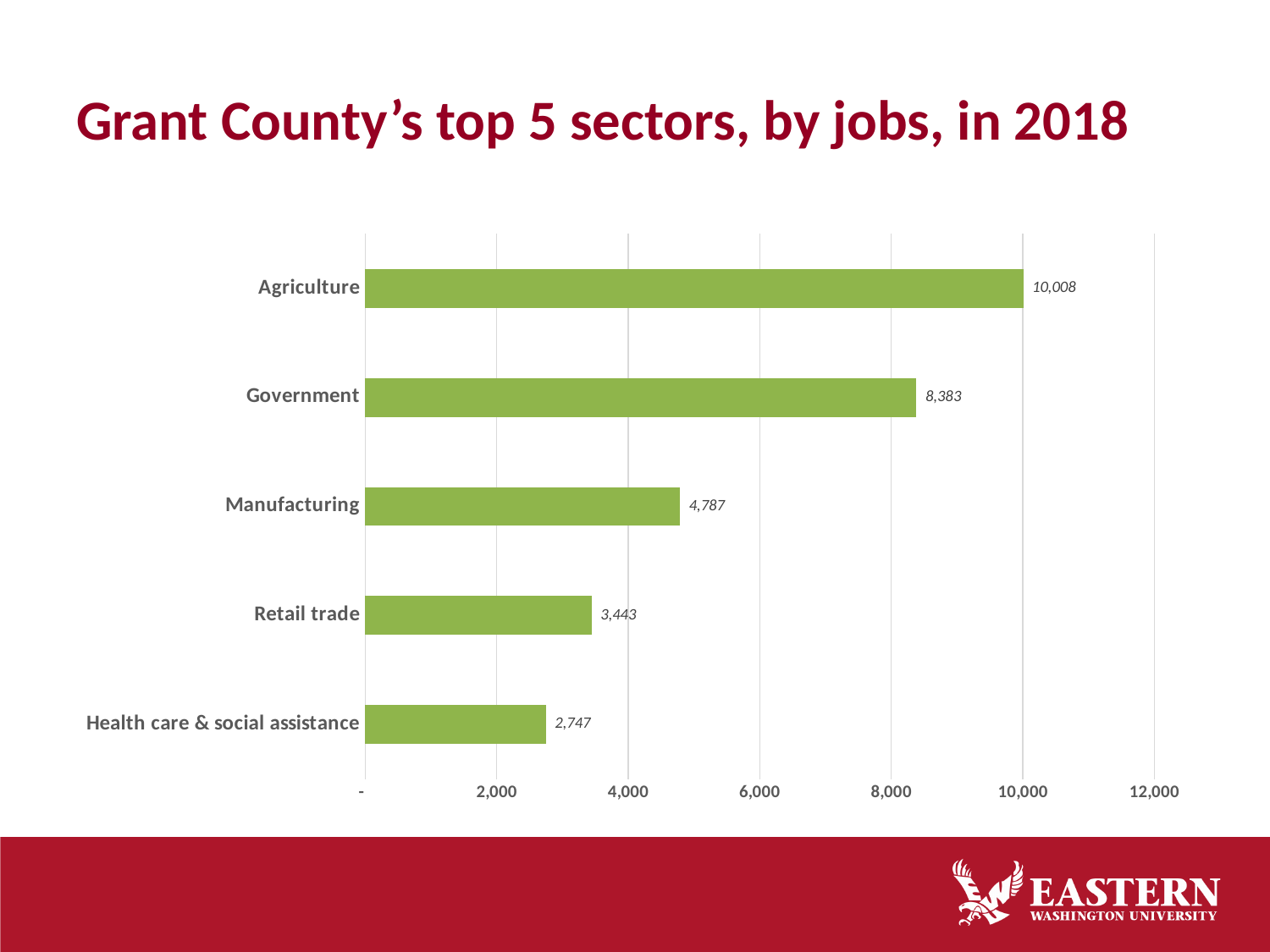
Which sector has the most jobs? Agriculture How many sectors are shown in the chart? 5 What is the difference between Retail trade and Health care & social assistance? 696 What is the difference in jobs between Agriculture and Government? 1,625 What is the value shown for Government? 8,383 How many jobs are shown for Manufacturing? 4,787 How many jobs does the Agriculture sector have? 10,008 What type of chart is shown on the slide? Bar chart Which sector has the fewest jobs? Health care & social assistance Which has more jobs, Manufacturing or Retail trade? Manufacturing Is the value for Government greater or less than 8,000? greater What is the value for Health care & social assistance? 2,747